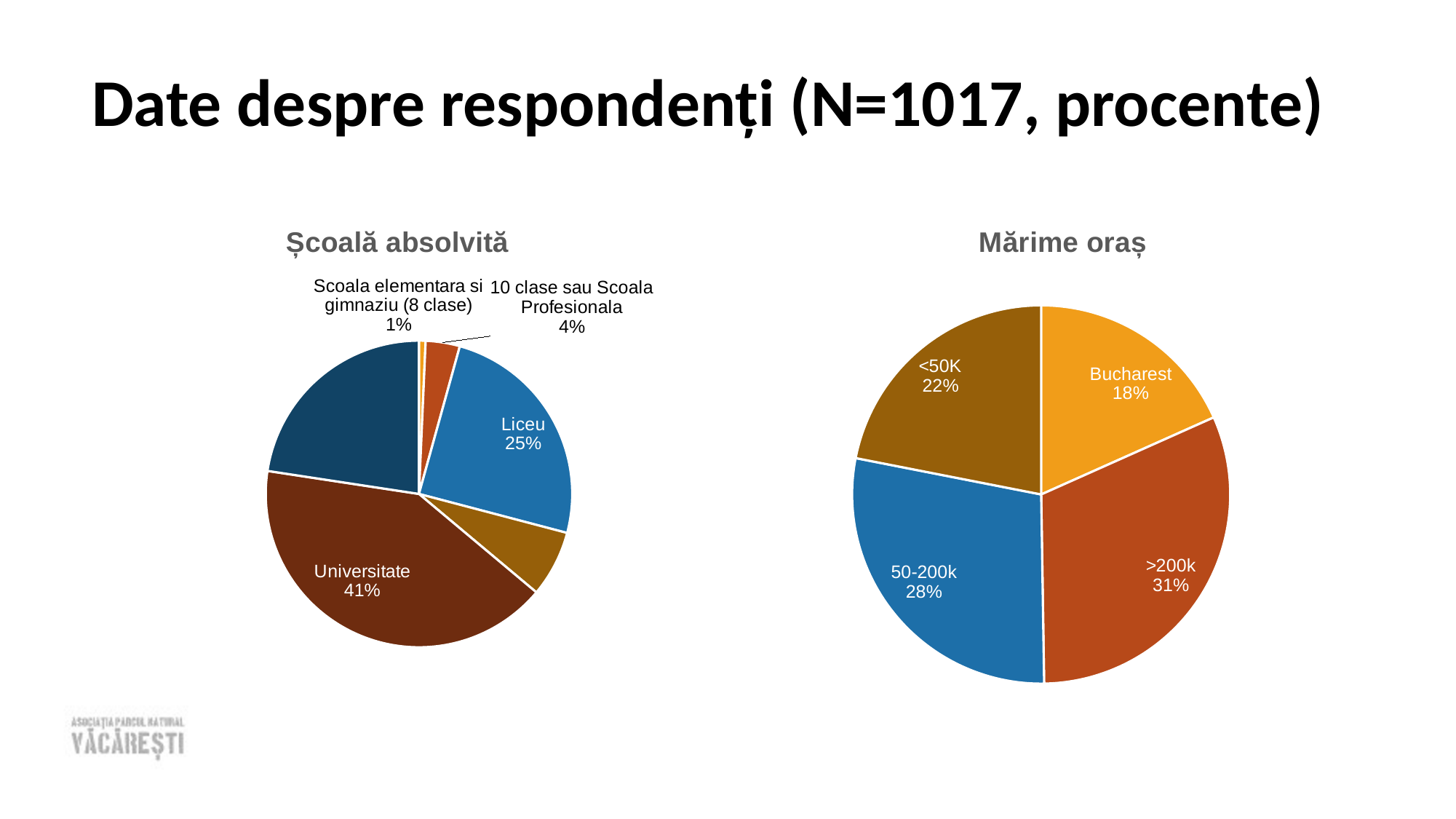
In the 'Școală absolvită' chart, which labelled category has the smallest share? Scoala elementara si gimnaziu (8 clase) In the 'Școală absolvită' chart, what percentage of respondents have 'Universitate'? 41% How many slices does the 'Mărime oraș' pie chart have? 4 In the 'Școală absolvită' chart, what percentage is shown for 'Liceu'? 25% What type of chart is used for 'Mărime oraș'? Pie chart In the 'Școală absolvită' chart, which labelled category has the largest share? Universitate In the 'Școală absolvită' chart, what is the difference in percentage points between 'Universitate' and 'Liceu'? 16 In the 'Mărime oraș' chart, what percentage is shown for '50-200k'? 28% In the 'Școală absolvită' chart, what percentage is shown for '10 clase sau Scoala Profesionala'? 4% In the 'Mărime oraș' chart, what percentage of respondents are from Bucharest? 18% In the 'Mărime oraș' chart, which category has the largest share? >200k In the 'Mărime oraș' chart, which is larger: '<50K' or 'Bucharest'? <50K